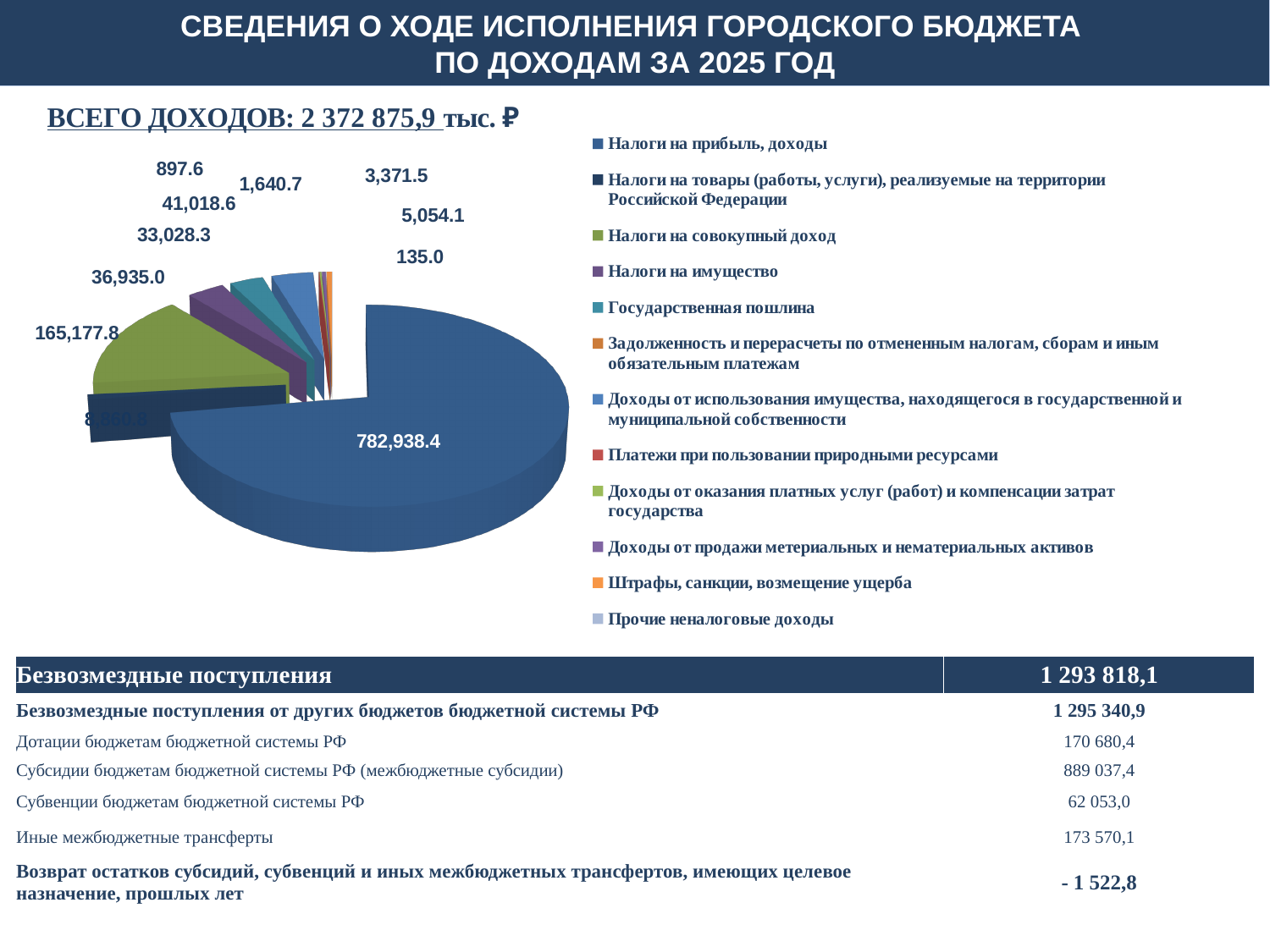
What is the value of the largest slice of the pie chart? 782,938.4 What is the difference between the values for Налоги на совокупный доход and Налоги на имущество? 128,242.8 Which category has the largest slice in the pie chart? Налоги на прибыль, доходы What is the difference between the values for Налоги на имущество and Государственная пошлина? 3,906.7 What is the smallest data label shown on the pie chart? 135.0 Which is larger in the pie chart: Налоги на имущество or Государственная пошлина? Налоги на имущество What kind of chart is shown on the slide? pie chart What is the value for Налоги на имущество in the pie chart? 36,935.0 What total income (ВСЕГО ДОХОДОВ) is stated above the pie chart? 2 372 875,9 тыс. ₽ What is the value for Государственная пошлина in the pie chart? 33,028.3 How many categories does the legend of the pie chart list? 12 What is the value for Налоги на совокупный доход in the pie chart? 165,177.8